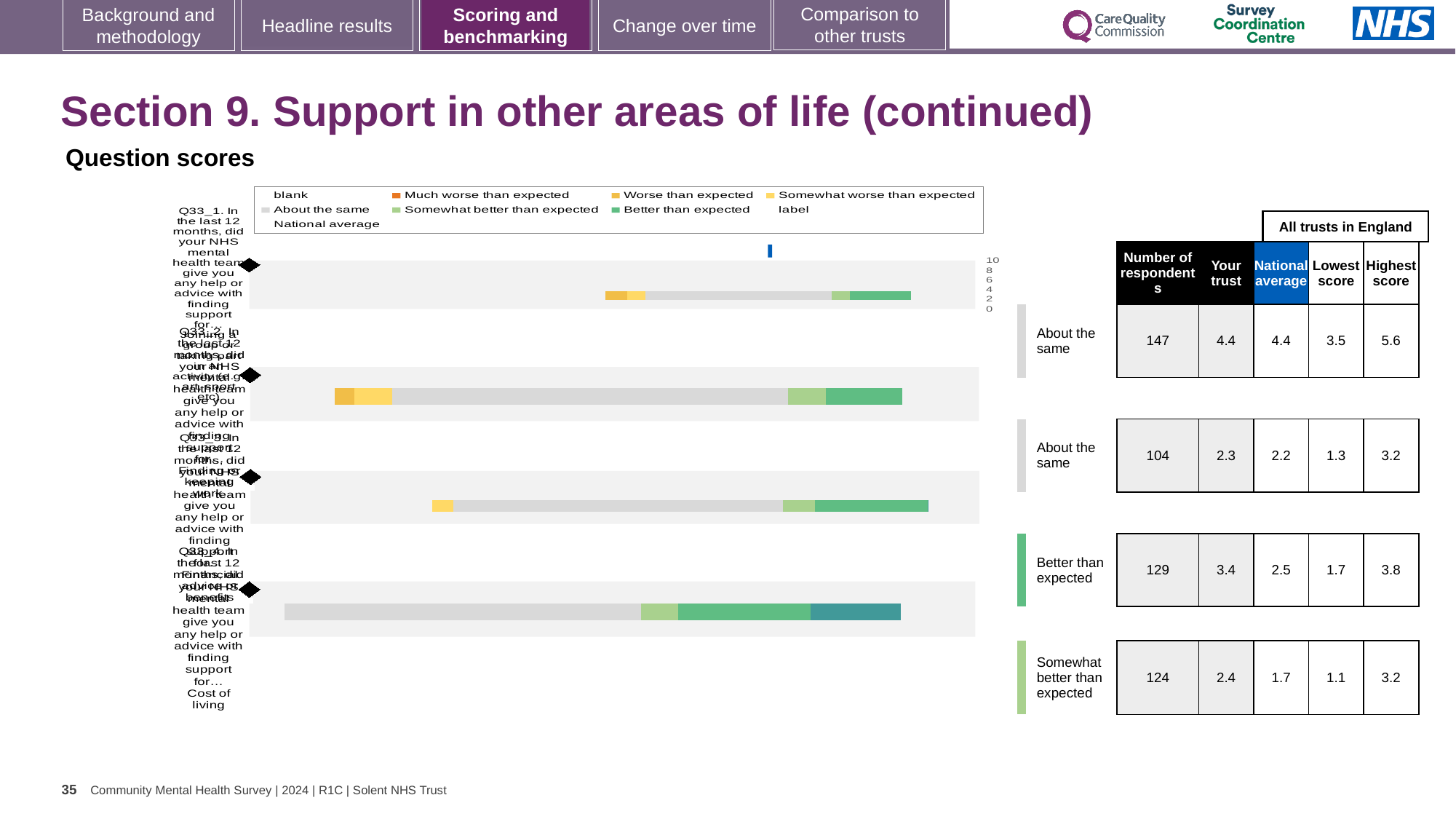
What kind of chart is shown on the slide? bar chart In the table beside the chart, which row has the highest 'Your trust' score? the first row (4.4) What benchmark label is shown beside the first (top) bar of the chart? About the same In the table beside the chart, what is the national average for the fourth row (Somewhat better than expected)? 1.7 In the table beside the chart, what is the 'Your trust' score for the third row (Better than expected)? 3.4 What colour represents 'Much worse than expected' in the chart legend? orange How many stacked bars are plotted in the chart? 4 What colour represents 'Better than expected' in the chart legend? green What benchmark label is shown beside the third bar of the chart? Better than expected What benchmark label is shown beside the fourth (bottom) bar of the chart? Somewhat better than expected In the table beside the chart, what is the number of respondents for the first row? 147 How many entries does the chart legend list? 9